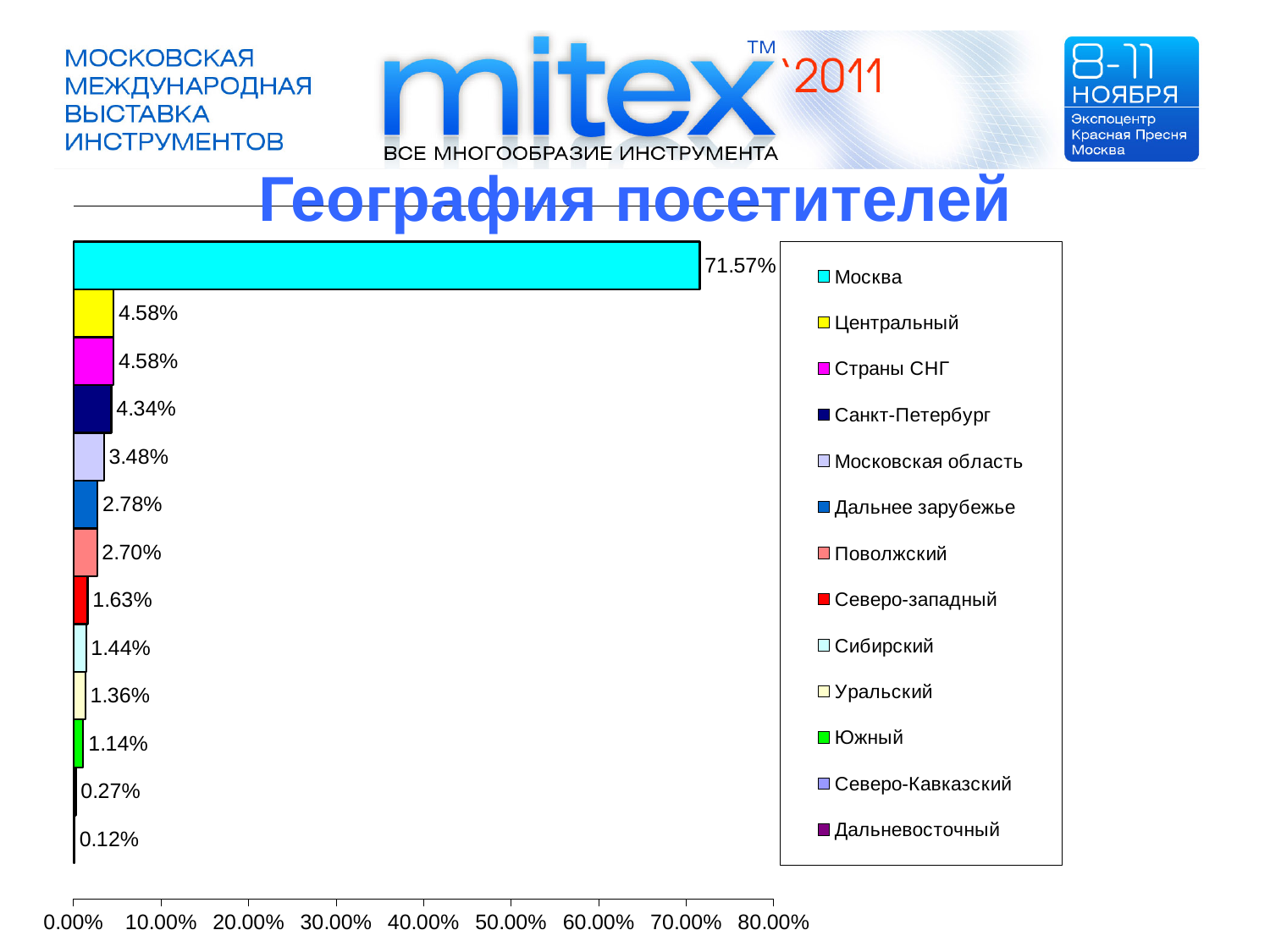
What is the value for Московская область? 3.48% Which category has the highest value? Москва Which category has the lowest value? Дальневосточный What is the title of the chart? География посетителей What is the value for Дальневосточный? 0.12% How many entries does the legend list? 13 What kind of chart is shown on the slide? bar chart Is the value for Москва greater or less than 70.00%? greater What is the value for Москва? 71.57% What is the value for Санкт-Петербург? 4.34% What is the difference between the values for Москва and Центральный? 66.99% Which is larger, the value for Дальнее зарубежье or the value for Северо-западный? Дальнее зарубежье